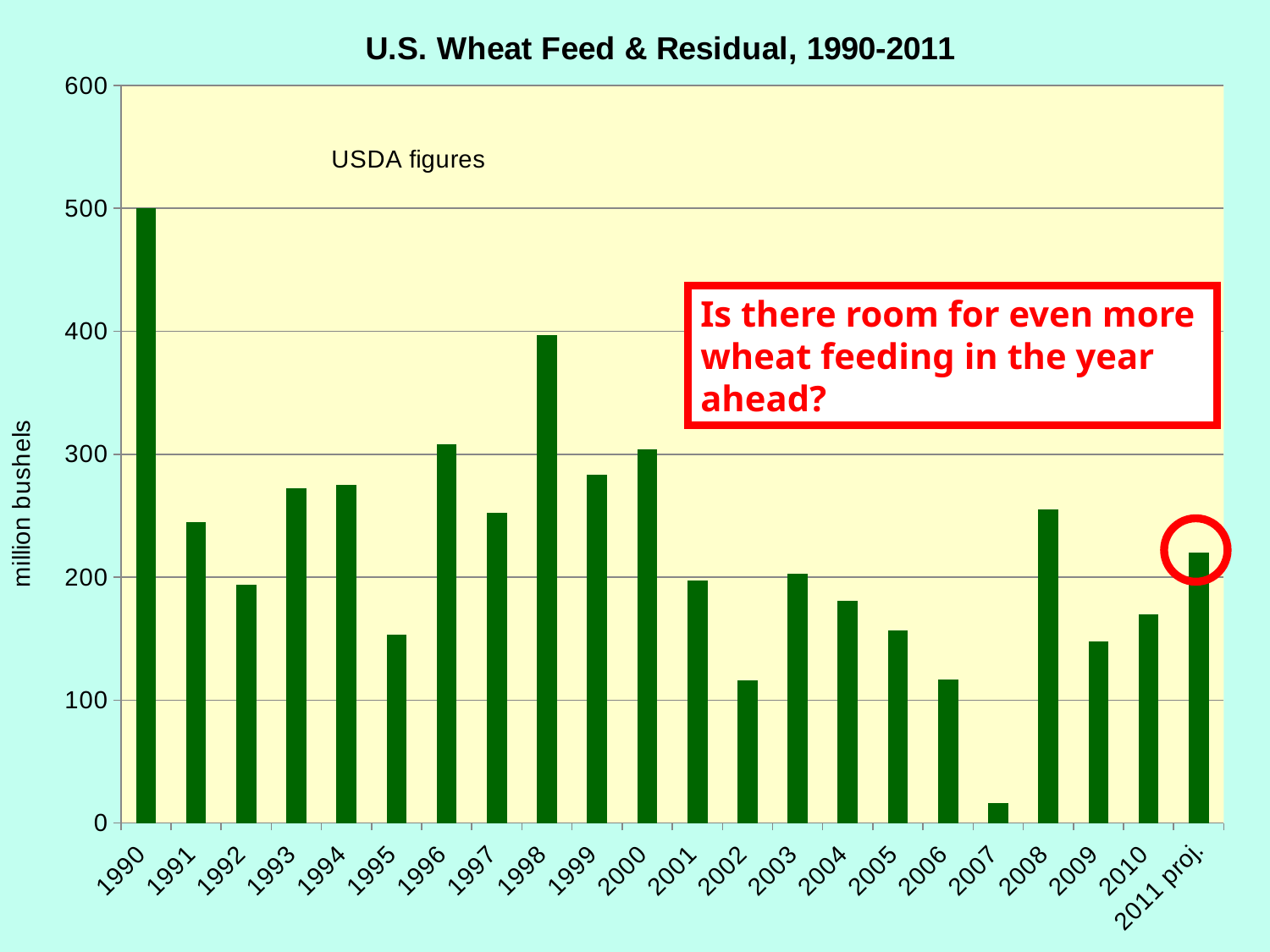
Is the value for 2009 greater or less than 200? less What kind of chart is shown on the slide? bar chart Which year has the lowest value? 2007 What unit is shown on the vertical axis label? million bushels Is the value for 1995 greater or less than 200? less How many bars (years) are plotted on the chart? 22 Is the value for 1998 greater or less than 300? greater What is the title of the chart? U.S. Wheat Feed & Residual, 1990-2011 Which is larger, the value for 1998 or the value for 2000? 1998 From 2005 to 2007, do the values rise or fall? fall Which year has the highest value? 1990